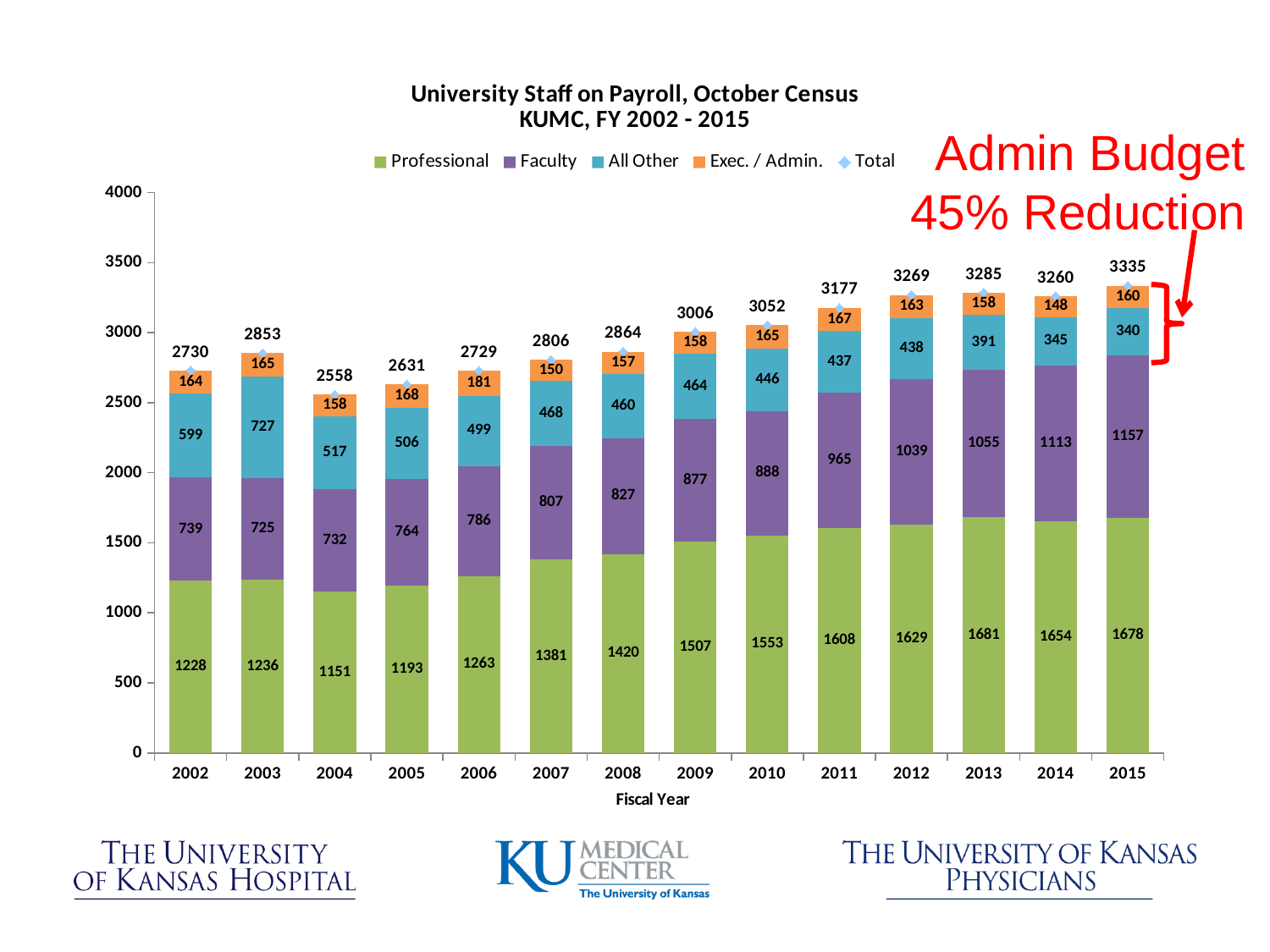
What is the Faculty value for fiscal year 2015? 1157 Which fiscal year has the lowest Total staff on payroll? 2004 Which is larger, the Exec. / Admin. value in 2006 or in 2014? 2006 What is the Total value for fiscal year 2010? 3052 Do the Total values generally rise or fall from 2004 to 2015? Rise What is the difference between the Professional value in 2015 and in 2002? 450 How many series does the legend list? 5 What kind of chart is shown on the slide? Stacked bar chart Which fiscal year has the lowest All Other value? 2015 Which fiscal year has the highest Total staff on payroll? 2015 How many fiscal years are shown on the x axis? 14 What is the Professional value for fiscal year 2002? 1228